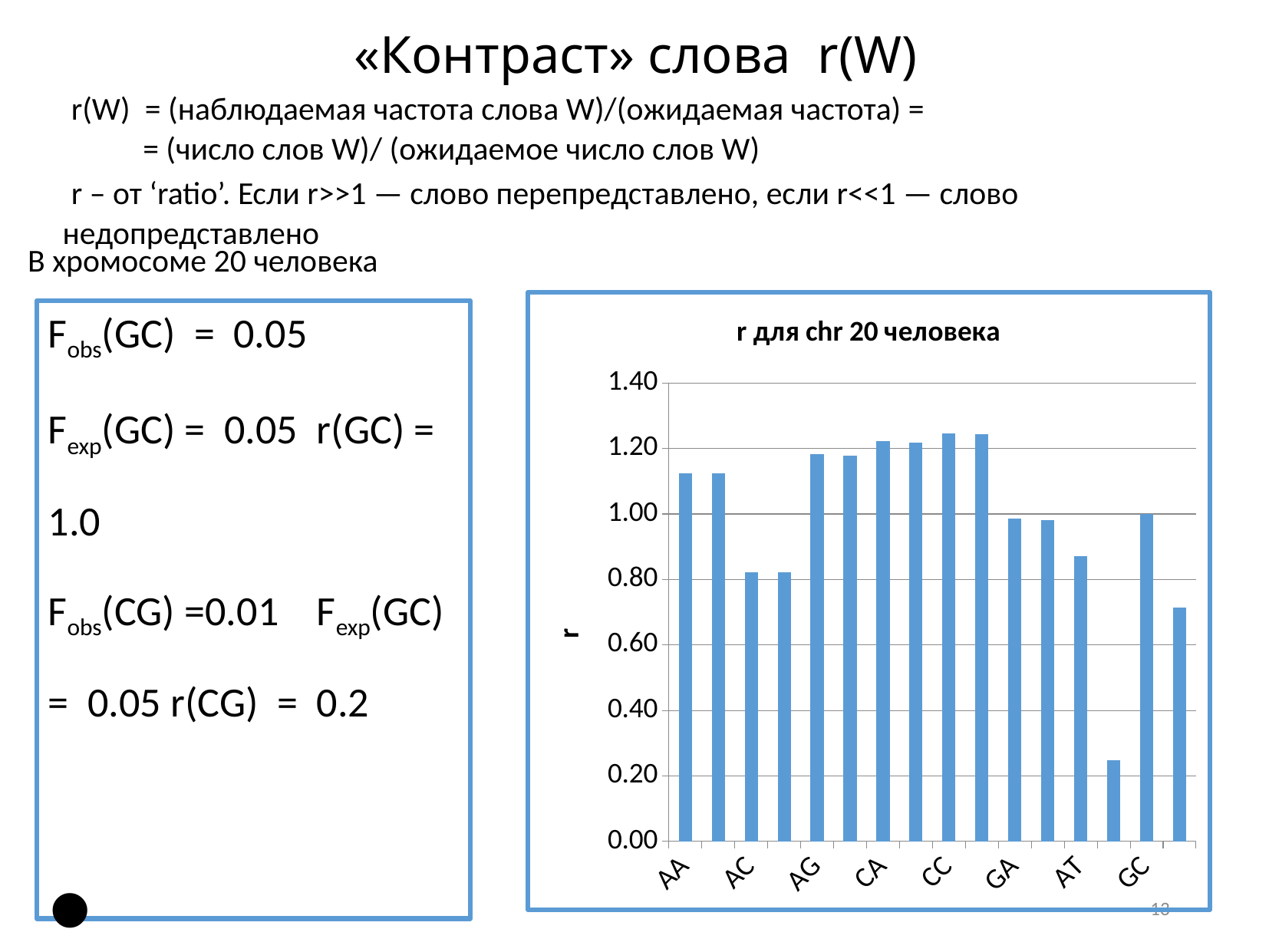
What kind of chart is shown on the slide? bar chart Is the value for AA greater or less than 1.00? greater What is the title of the chart? r для chr 20 человека Which has the larger value, AA or AT? AA Is the value for AC greater or less than 0.60? greater Is the value for AT greater or less than 1.00? less How many category labels are shown on the x axis of the chart? 8 What is the label of the vertical axis of the chart? r Which has the larger value, CC or AC? CC